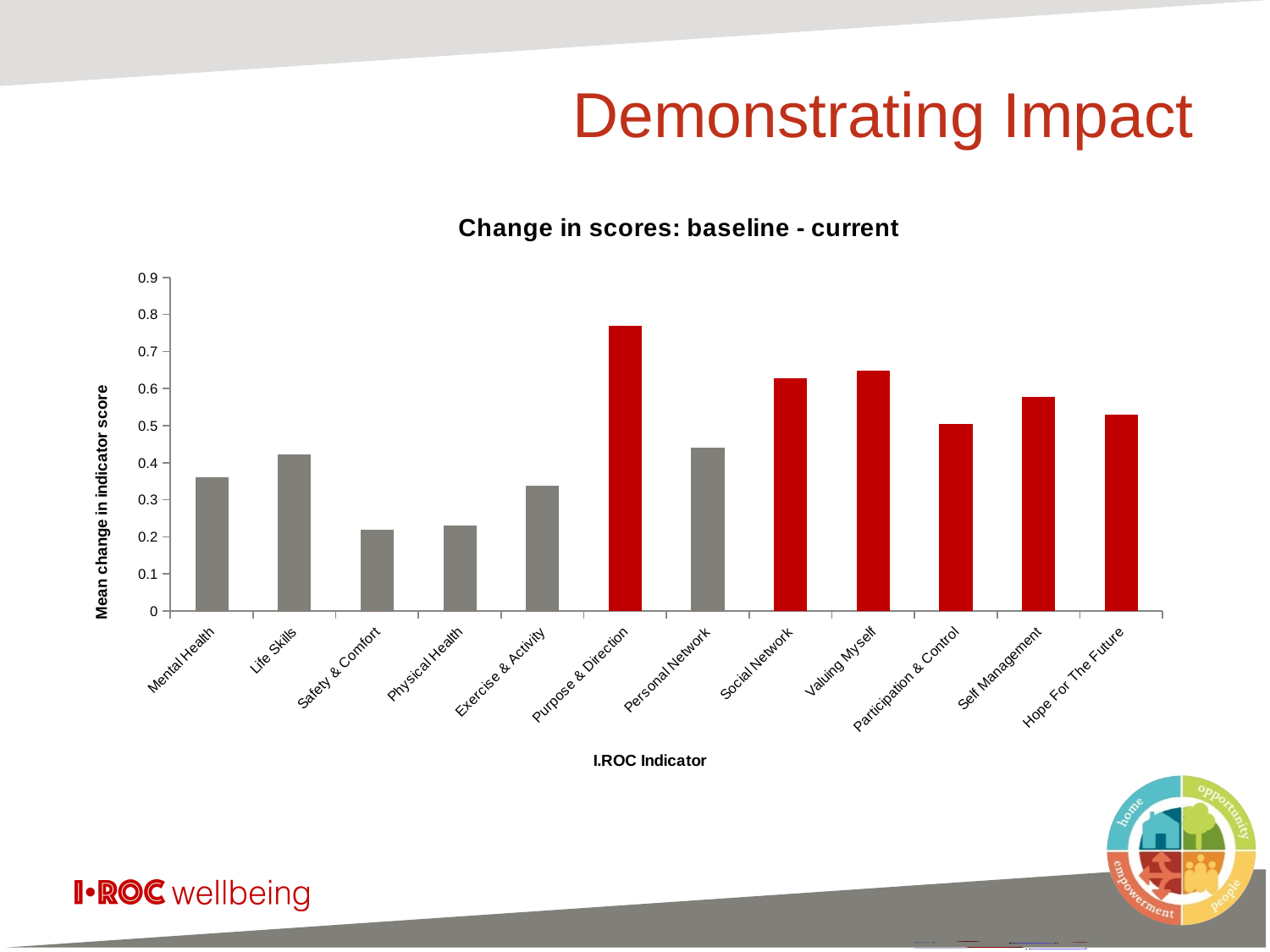
Is the value for Social Network greater or less than 0.6? greater Is the value for Mental Health greater or less than 0.4? less What kind of chart is shown on the slide? Bar chart Which indicator has the highest mean change in indicator score? Purpose & Direction Is the value for Purpose & Direction greater or less than 0.7? greater How many I.ROC indicators are plotted on the x axis? 12 Which has a larger mean change: Purpose & Direction or Social Network? Purpose & Direction Which has a larger mean change: Life Skills or Mental Health? Life Skills What is the title of the chart? Change in scores: baseline - current What is the label on the y axis of the chart? Mean change in indicator score